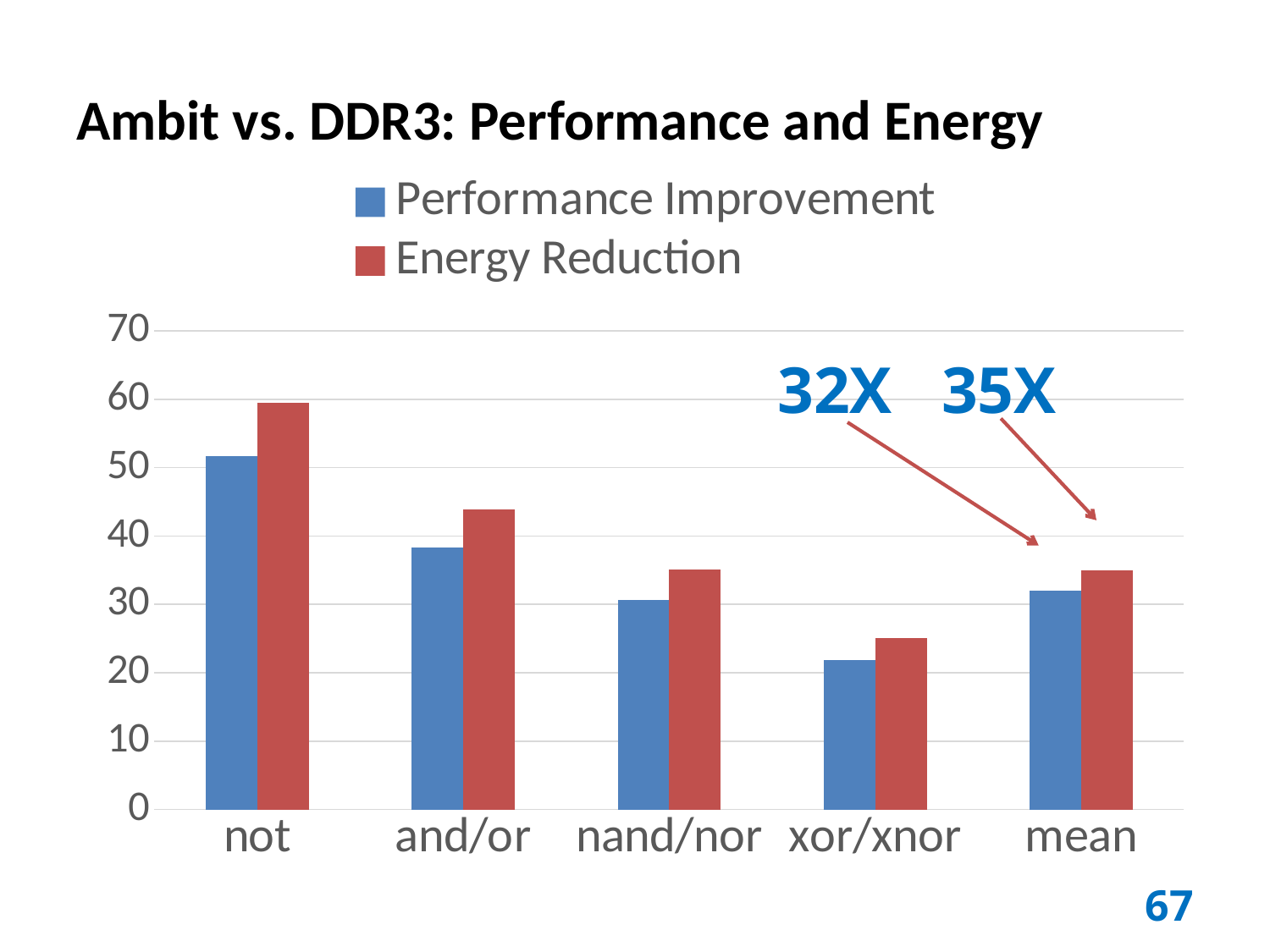
How many series does the legend list? 2 What is the Performance Improvement value for mean, as annotated on the chart? 32X Is the Performance Improvement value for xor/xnor greater or less than 30? less How many categories are shown on the x axis? 5 Is the Energy Reduction value for not greater or less than 50? greater What colour are the Energy Reduction bars? red Which category has the highest Performance Improvement? not For and/or, which is larger: Performance Improvement or Energy Reduction? Energy Reduction What is the Energy Reduction value for mean, as annotated on the chart? 35X What kind of chart is shown on the slide? bar chart Which category has the lowest Energy Reduction? xor/xnor Do the Performance Improvement values rise or fall from not to xor/xnor? fall